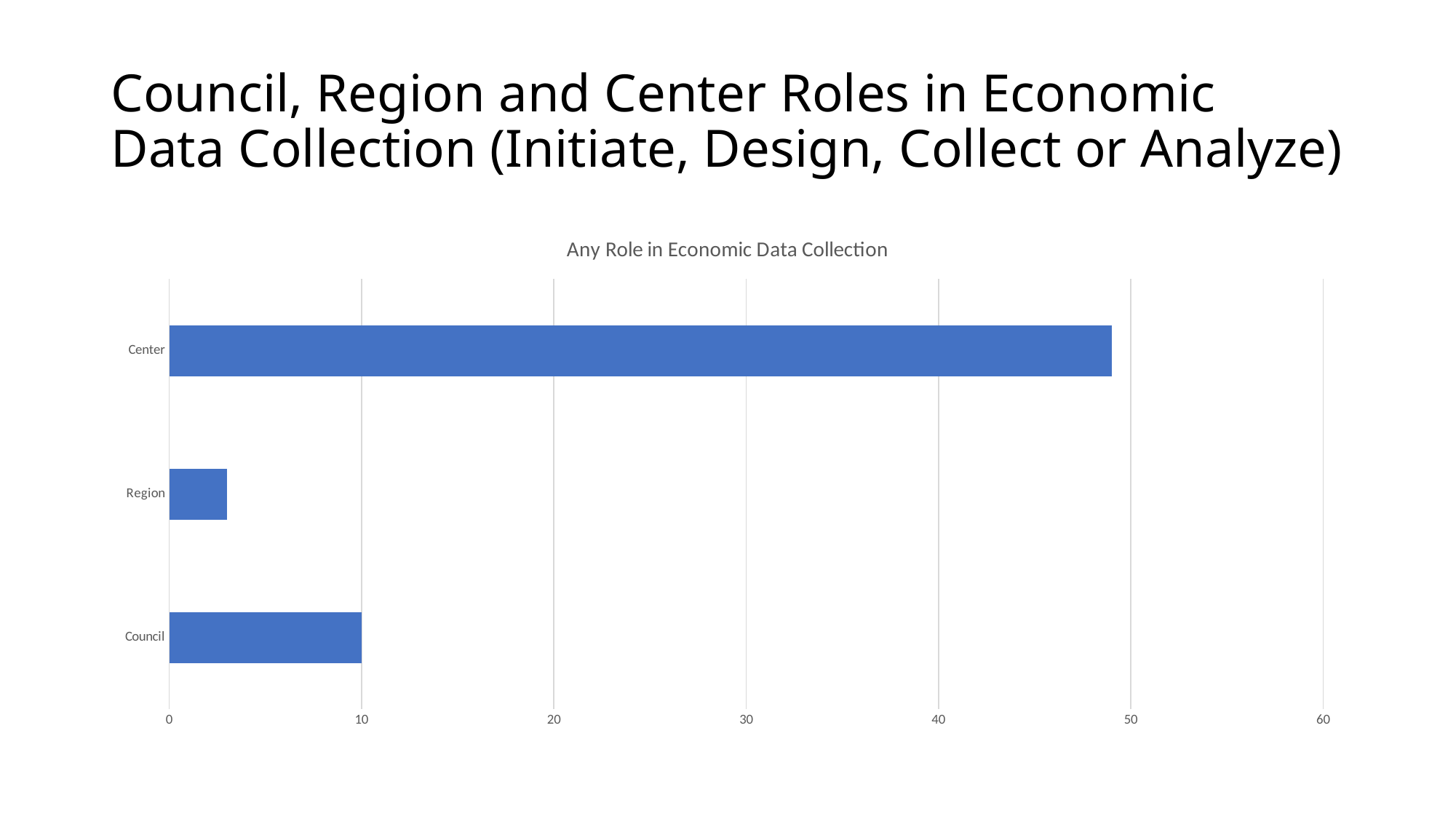
Is the value for Region greater or less than 10? less What is the title of the chart? Any Role in Economic Data Collection Is the value for Center greater or less than 40? greater Which has a larger value, Council or Region? Council What is the highest value shown on the horizontal axis? 60 What is the value for Council? 10 Which category has the highest value? Center Which category has the lowest value? Region Which has a larger value, Center or Council? Center How many categories are plotted in the chart? 3 What kind of chart is shown on the slide? bar chart